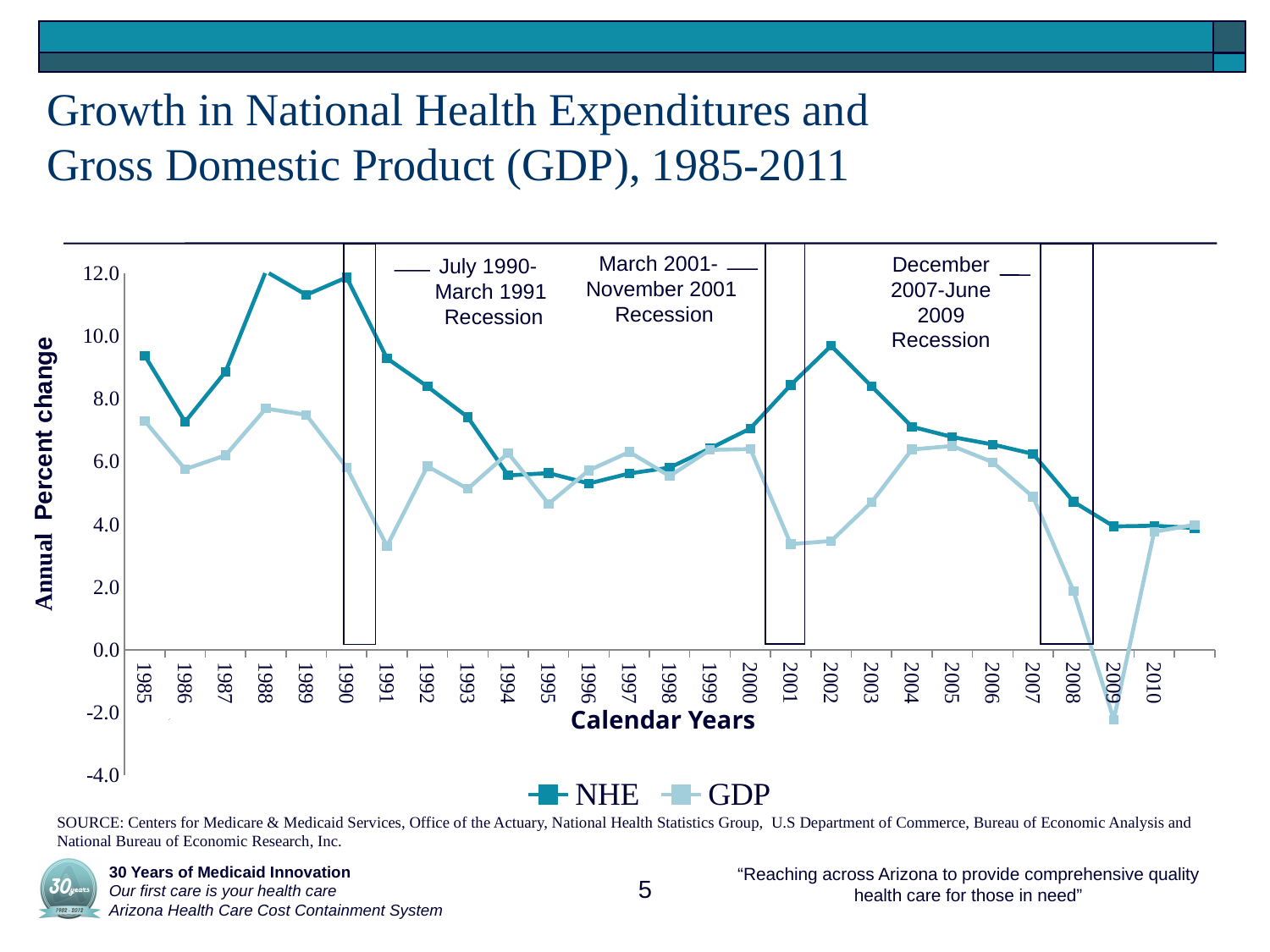
Is the NHE value for 1985 greater or less than 8.0? greater In 1985, which series has the higher value, NHE or GDP? NHE Does the NHE series rise or fall from 2002 to 2009? fall How many series does the legend list? 2 Which series does the legend list besides NHE? GDP Is the GDP value for 1991 greater or less than 4.0? less Is the GDP value for 2009 greater or less than 0.0? less In 1994, which series has the higher value, NHE or GDP? GDP What kind of chart is shown on the slide? line chart What is the title of the vertical axis? Annual Percent change In which year is the GDP series at its lowest? 2009